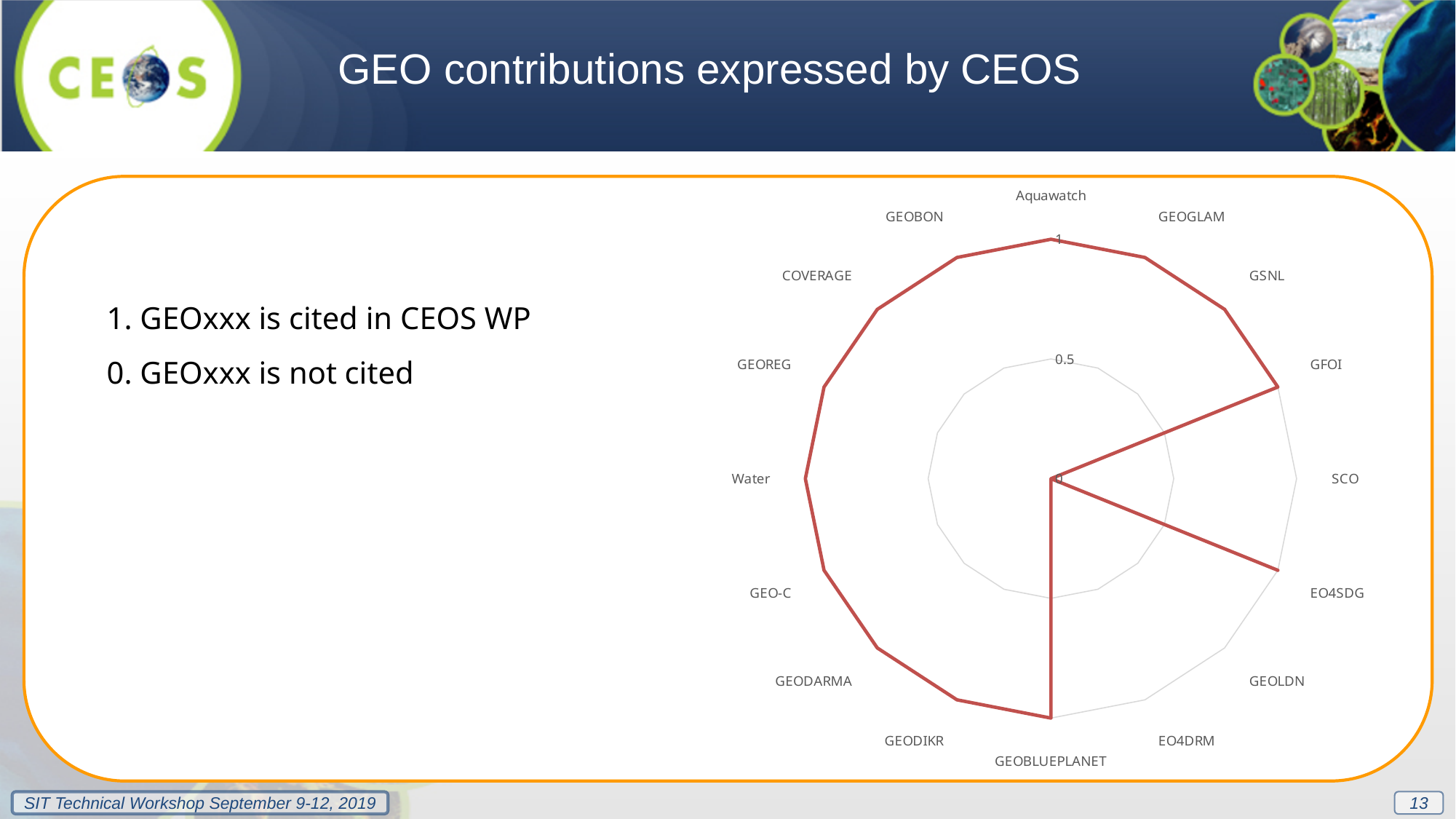
How many categories have a plotted value of 0? 3 How many categories are plotted around the radar chart? 16 What kind of chart is shown on the slide? Radar chart What is the value plotted for SCO? 0 What is the value plotted for GEOLDN? 0 Is the value for Water greater or less than 0.5? greater Is the value for EO4DRM greater or less than 0.5? less Which is larger, the value for EO4SDG or the value for GEOLDN? EO4SDG What is the value plotted for GFOI? 1 What is the value plotted for GEOBLUEPLANET? 1 What is the title of the slide containing the chart? GEO contributions expressed by CEOS What is the difference between the value for GSNL and the value for SCO? 1